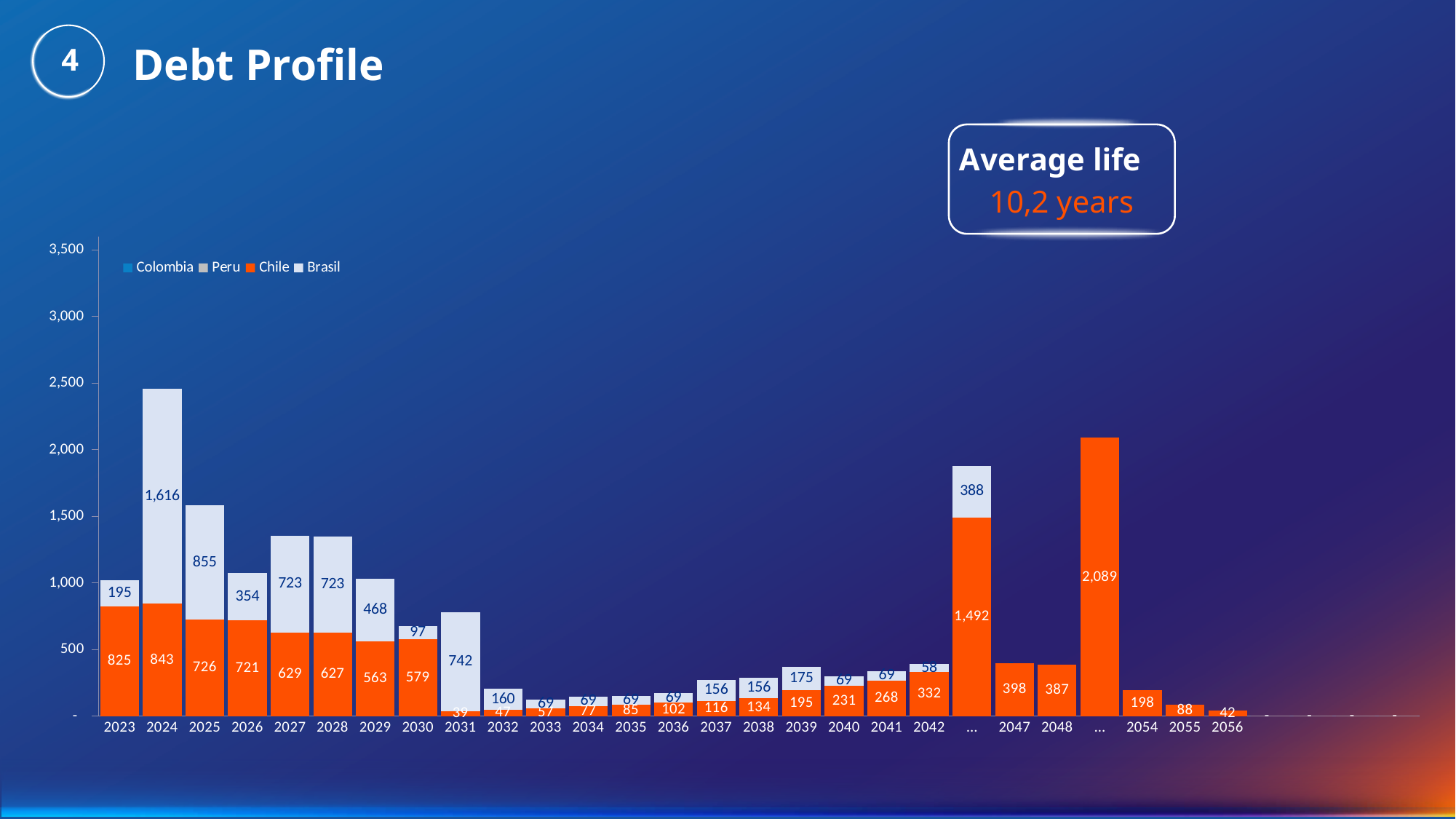
Is the total of the 2024 bar greater or less than 2,000? greater What is the difference between the Chile values for 2024 and 2023? 18 Which is larger, the Chile value for 2048 or the Chile value for 2054? 2048 Which year has the lowest labelled Chile value? 2031 What kind of chart is shown on the slide? Stacked bar chart What is the Chile value for 2047? 398 What is the Chile value for 2024? 843 What is the Brasil value for 2031? 742 What is the Brasil value for 2024? 1,616 Which year has the highest Brasil value? 2024 What is the total of the stacked bar for 2023? 1,020 How many series does the legend list? 4